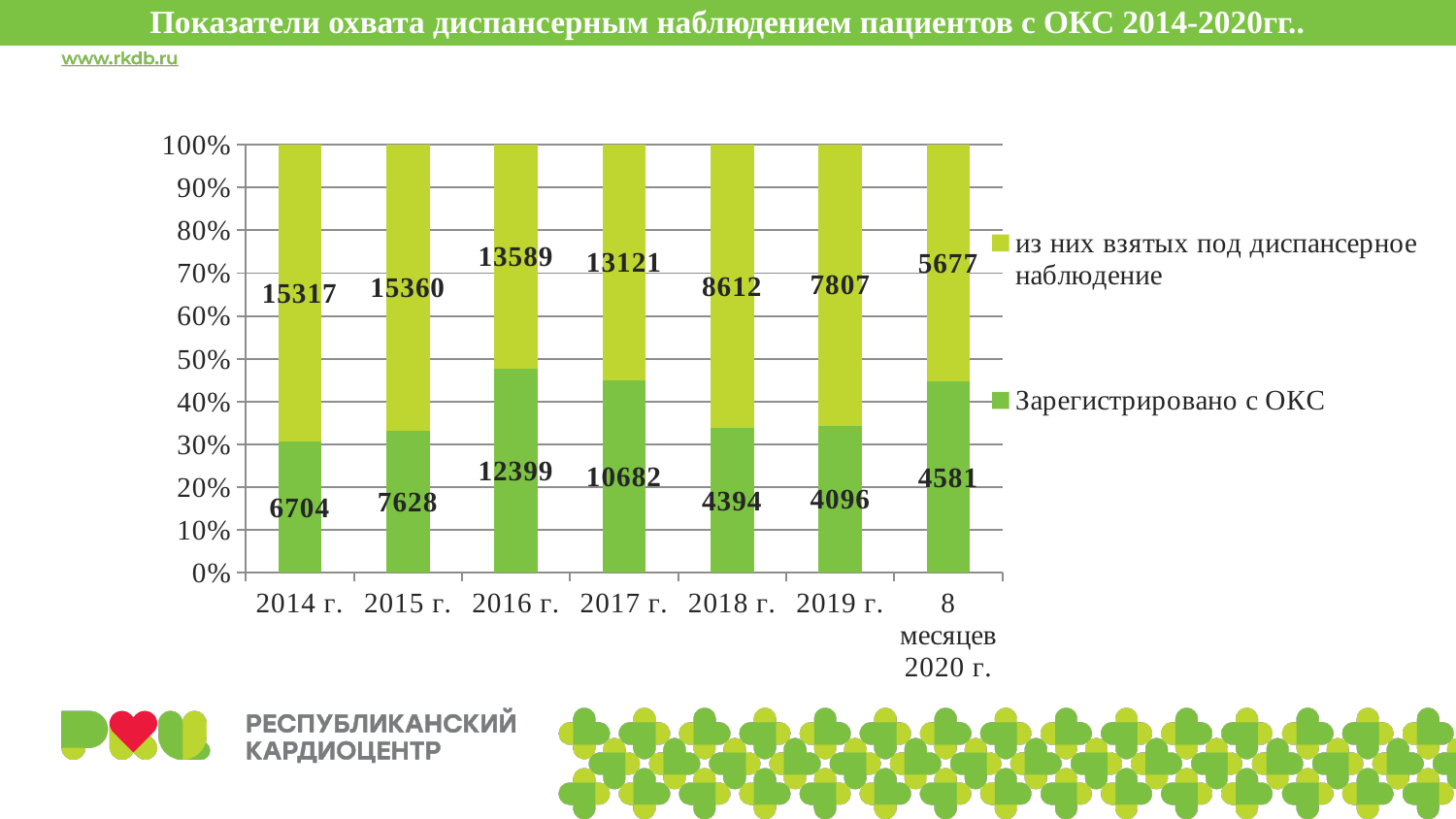
What is the difference between the 'из них взятых под диспансерное наблюдение' values for 2016 г. and 2017 г.? 468 What is the value of 'Зарегистрировано с ОКС' for 8 месяцев 2020 г.? 4581 How many categories are shown on the x axis? 7 In which category is the value of 'Зарегистрировано с ОКС' the lowest? 2019 г. In which category is the value of 'из них взятых под диспансерное наблюдение' the highest? 2015 г. What kind of chart is shown on the slide? Stacked bar chart How many series does the legend list? 2 What is the sum of the two data labels shown on the bar for 2014 г.? 22021 Which is larger: the 'Зарегистрировано с ОКС' value for 2014 г. or for 2015 г.? 2015 г. What is the value of 'Зарегистрировано с ОКС' for 2016 г.? 12399 What is the value of 'из них взятых под диспансерное наблюдение' for 2019 г.? 7807 Is the share of the 'Зарегистрировано с ОКС' segment for 2016 г. greater or less than 40%? greater